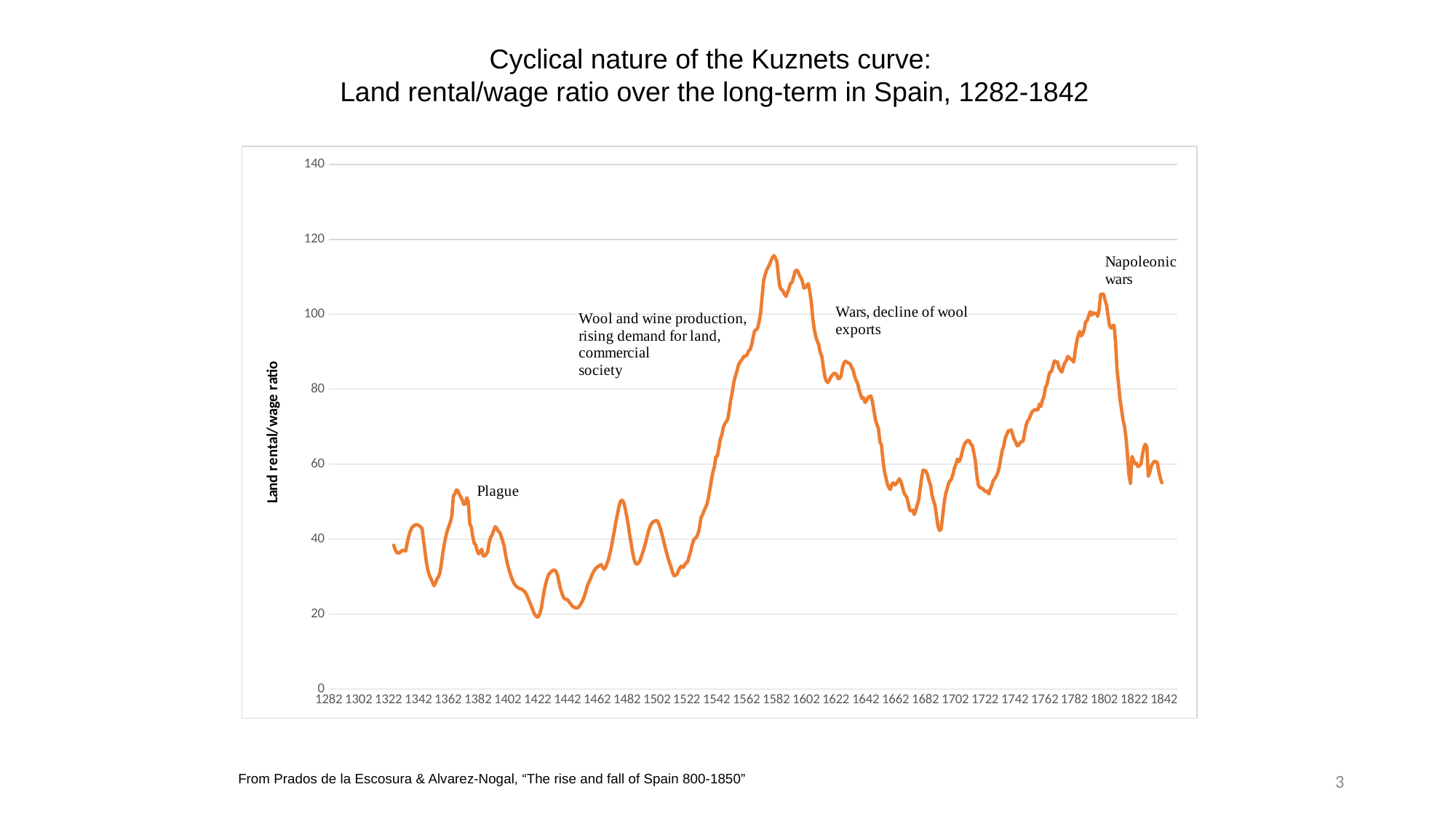
Near which x-axis year does the land rental/wage ratio reach its highest value? 1582 What is the label on the vertical axis of the chart? Land rental/wage ratio Which annotation is placed next to the peak around 1362 on the chart? Plague Is the value of the land rental/wage ratio at its peak around 1802 greater or less than 80? greater Which is higher: the peak of the land rental/wage ratio around 1582 or the peak around 1802? the peak around 1582 Near which x-axis year does the land rental/wage ratio reach its lowest value? 1422 Is the value of the land rental/wage ratio at 1842 greater or less than 80? less Does the land rental/wage ratio rise or fall between 1602 and 1682? fall Is the value of the land rental/wage ratio at its peak around 1582 greater or less than 100? greater What kind of chart is shown on the slide? line chart